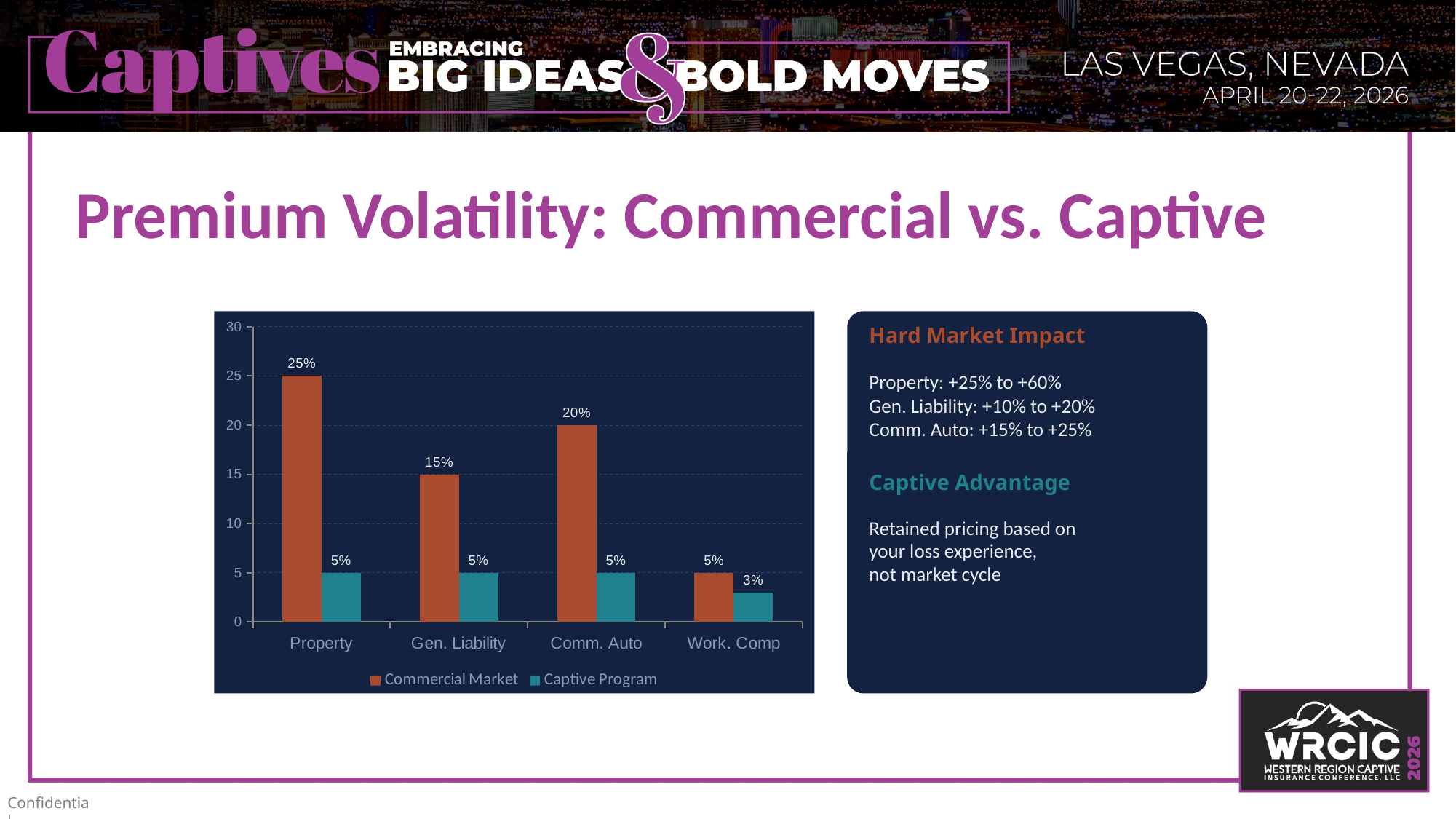
What kind of chart is shown on the slide? Bar chart What is the difference between the Commercial Market and Captive Program values for Gen. Liability? 10% What is the Commercial Market value for Property? 25% What are the two series named in the chart legend? Commercial Market and Captive Program Which category has the highest Commercial Market value? Property Is the Commercial Market value for Property greater or less than 20? greater How many categories are shown on the x axis? 4 What is the Commercial Market value for Comm. Auto? 20% Which is larger for Comm. Auto: the Commercial Market value or the Captive Program value? Commercial Market Which category has the lowest Captive Program value? Work. Comp What is the Captive Program value for Work. Comp? 3% How many series does the legend list? 2